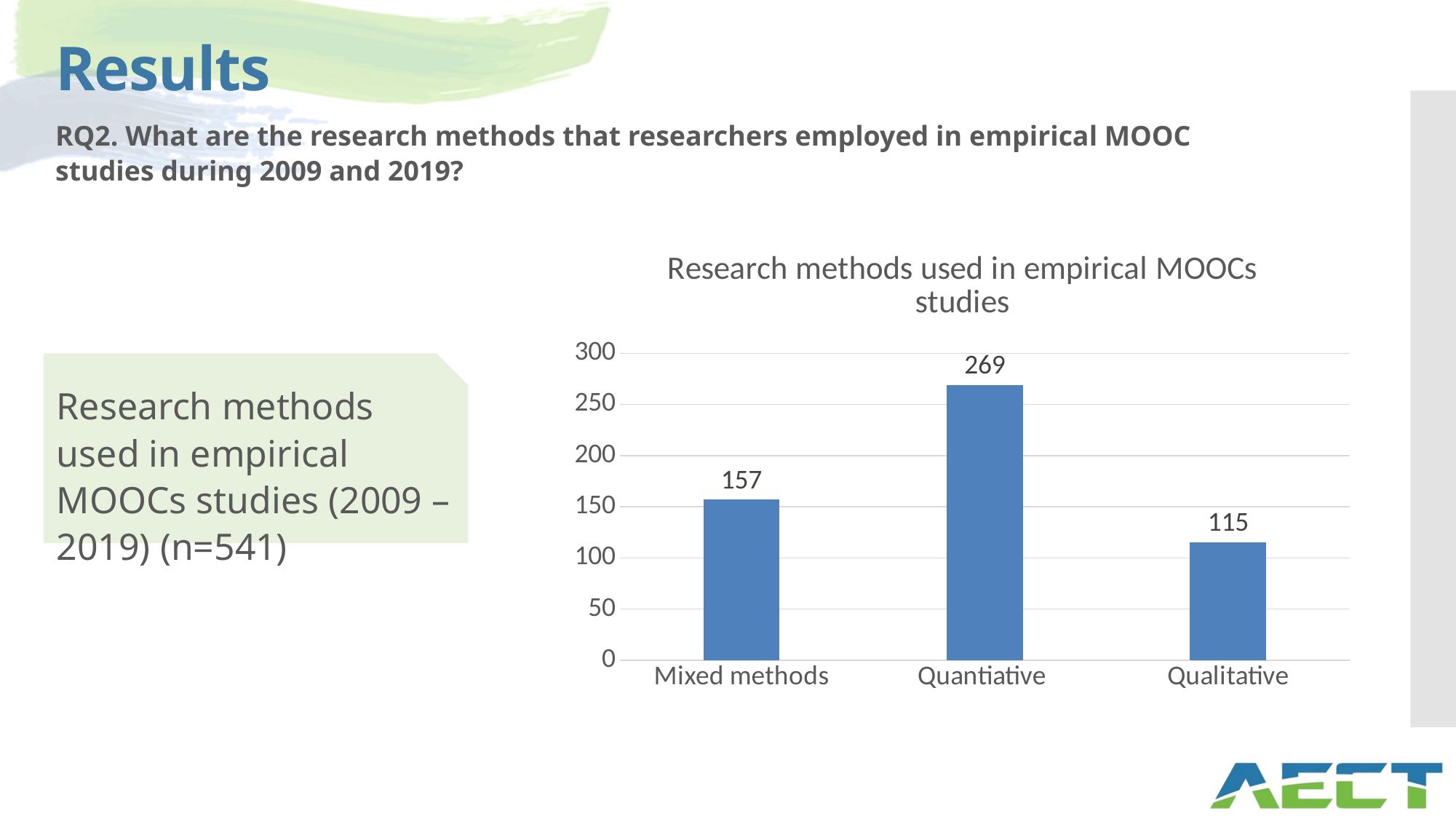
What is the difference between the values for Mixed methods and Qualitative? 42 What kind of chart is shown on the slide? bar chart Which is larger, the value for Mixed methods or the value for Qualitative? Mixed methods What is the difference between the values for Quantiative and Mixed methods? 112 How many categories are shown on the x axis? 3 Is the value for Quantiative greater or less than 250? greater What is the title of the chart? Research methods used in empirical MOOCs studies Which research method has the highest value? Quantiative What is the value for Qualitative? 115 What is the value for Mixed methods? 157 Which research method has the lowest value? Qualitative What is the value for Quantiative? 269